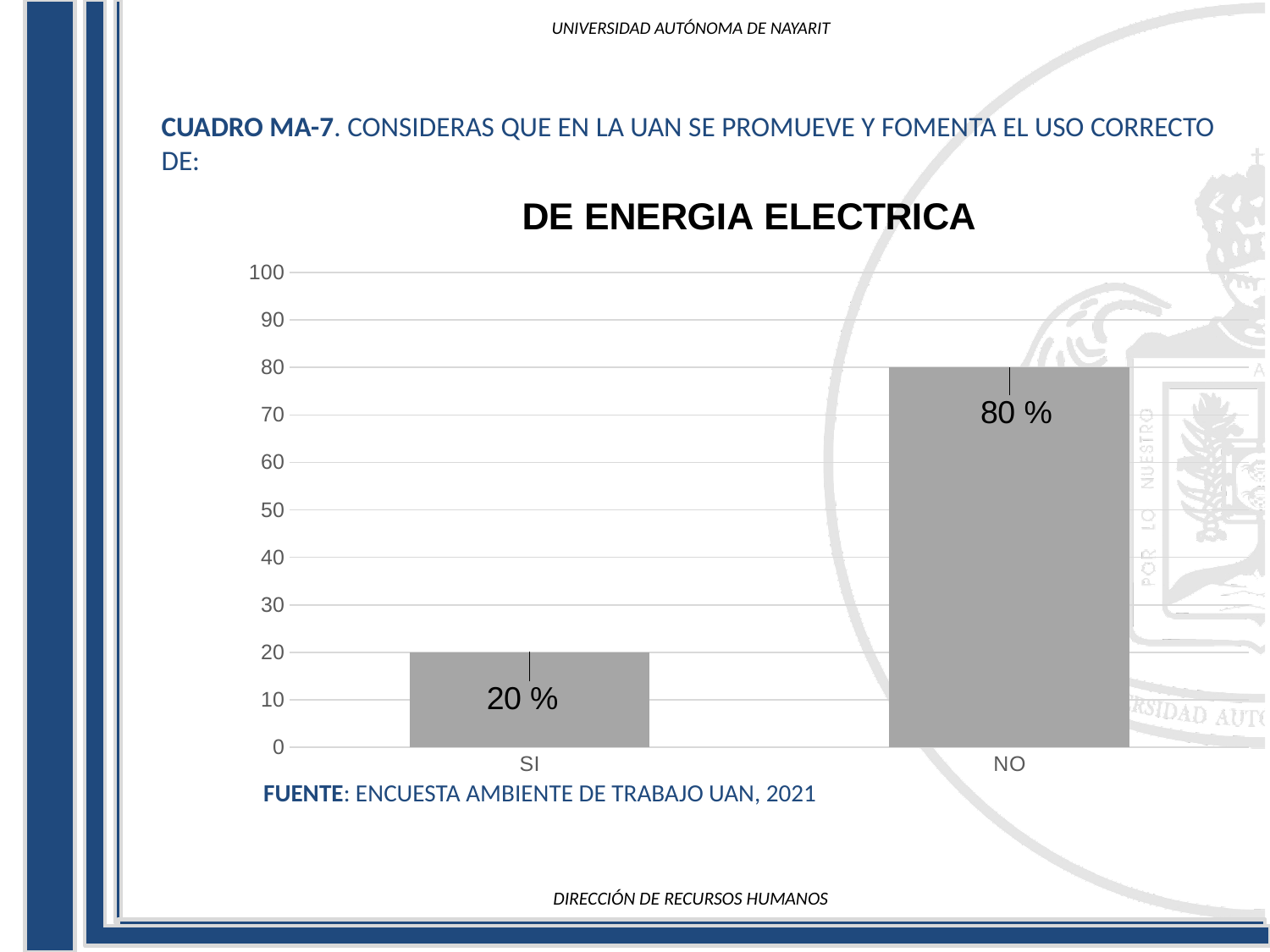
Which is larger, the value for SI or the value for NO? NO Is the value for SI greater or less than 30? less What is the highest value shown on the vertical axis? 100 What is the difference between the values for NO and SI? 60 % Is the value for NO greater or less than 50? greater What is the value for SI? 20 % What is the title of the chart? DE ENERGIA ELECTRICA What is the value for NO? 80 % What kind of chart is shown on the slide? bar chart How many categories are shown on the chart? 2 Which category has the lowest value? SI Which category has the highest value? NO